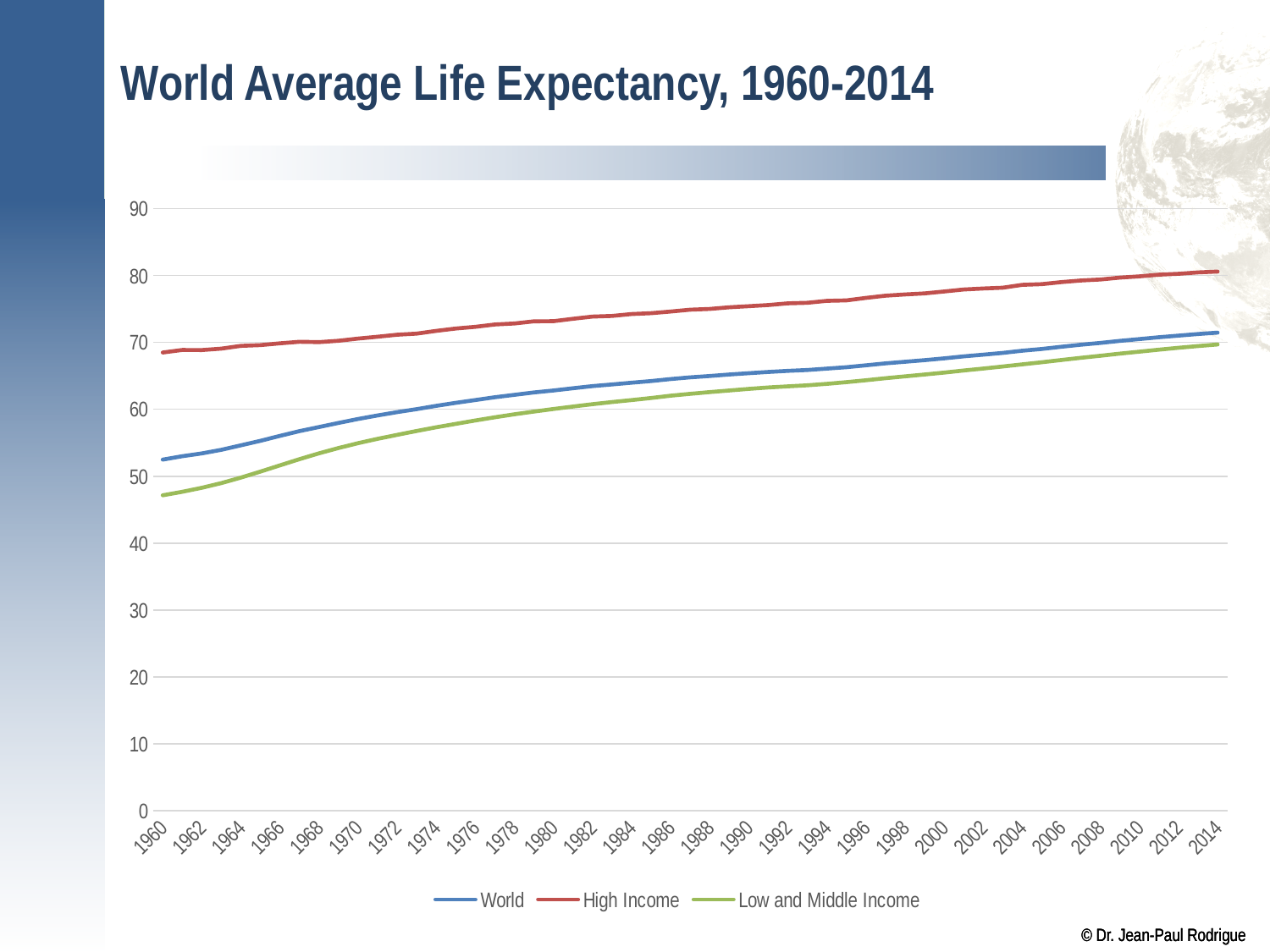
Which series has the highest value in 2014? High Income Does the World series rise or fall from 1960 to 2014? rise Is the value for Low and Middle Income in 1960 greater or less than 50? less Does the Low and Middle Income series rise or fall over the period shown? rise How many series does the legend list? 3 Which series has the lowest value in 1960? Low and Middle Income What kind of chart is shown on the slide? line chart In 1960, which is larger: the World value or the Low and Middle Income value? World Which series is drawn in red? High Income Is the value for World in 1960 greater or less than 50? greater What is the title of the chart? World Average Life Expectancy, 1960-2014 Is the value for High Income in 1990 greater or less than 70? greater